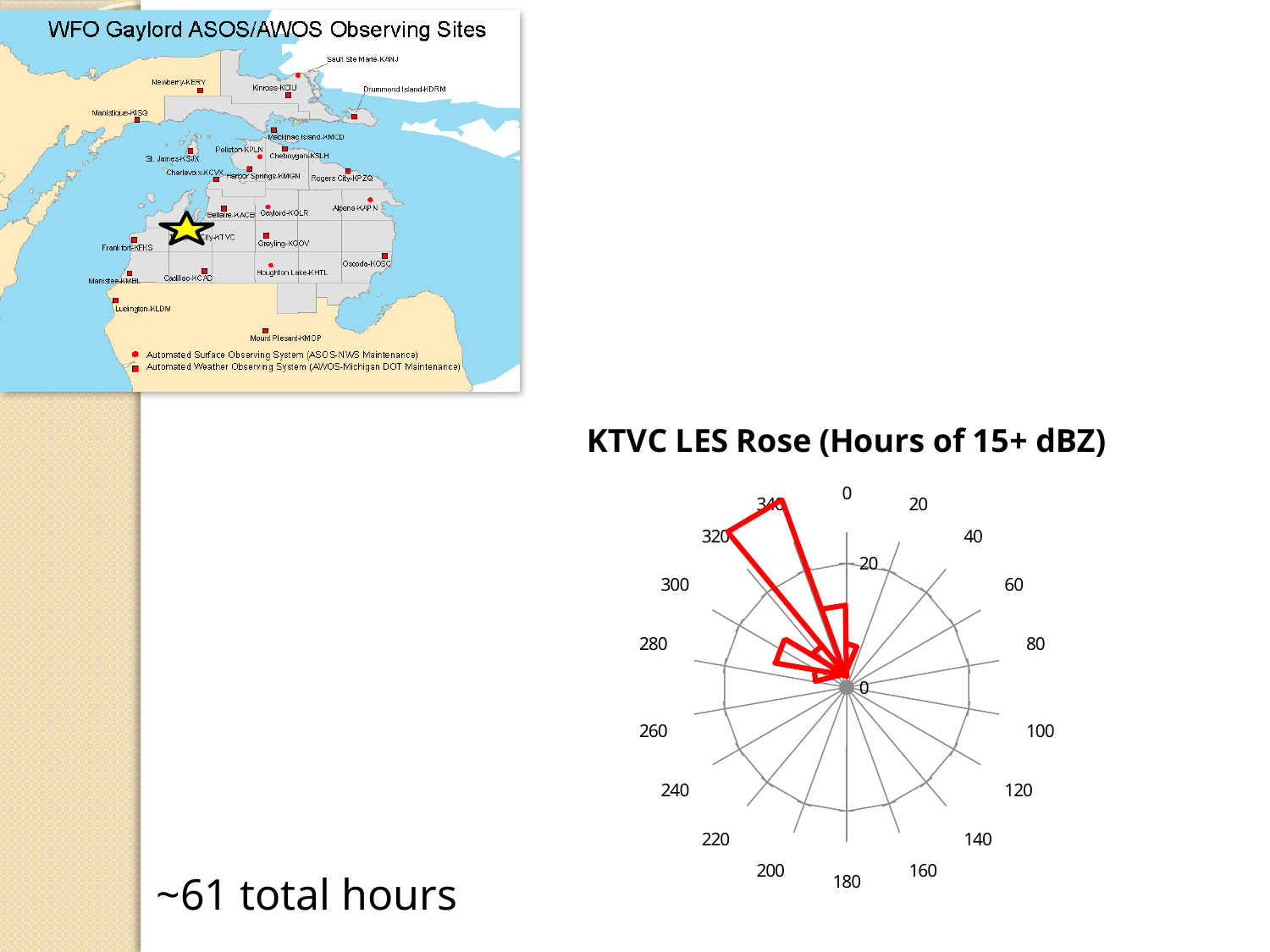
How many direction categories are labelled around the chart? 18 What kind of chart is shown on the slide? radar chart Which direction has the larger value, 340 or 280? 340 Is the value for direction 340 greater or less than 20? greater Is the value for direction 280 greater or less than 20? less Is the value for direction 180 greater or less than 20? less What is the highest radial axis tick label printed on the chart? 20 What is the title of the chart? KTVC LES Rose (Hours of 15+ dBZ)